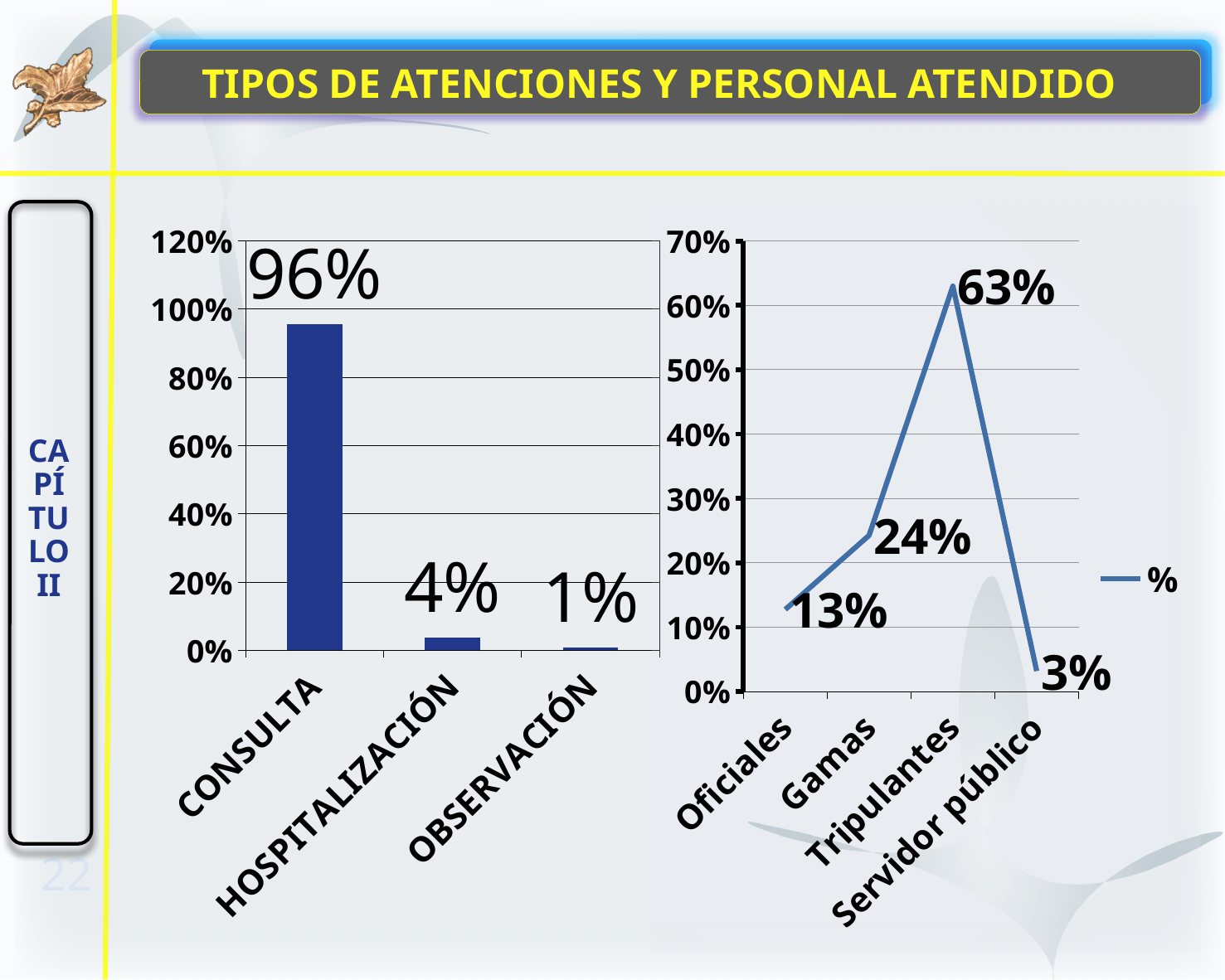
In the right chart, what is the value for Servidor público? 3% In the right chart, which category has the highest value? Tripulantes In the right chart, what is the difference between the values for Tripulantes and Gamas? 39% What kind of chart is the left chart? bar chart In the left chart, how many categories are shown? 3 In the left chart, which category has the lowest value? OBSERVACIÓN What kind of chart is the right chart? line chart In the left chart, what is the difference between the values for CONSULTA and HOSPITALIZACIÓN? 92% In the right chart, what is the value for Tripulantes? 63% In the left chart, what is the value for HOSPITALIZACIÓN? 4% In the left chart, what is the value for CONSULTA? 96% In the right chart, which is larger, the value for Oficiales or the value for Gamas? Gamas